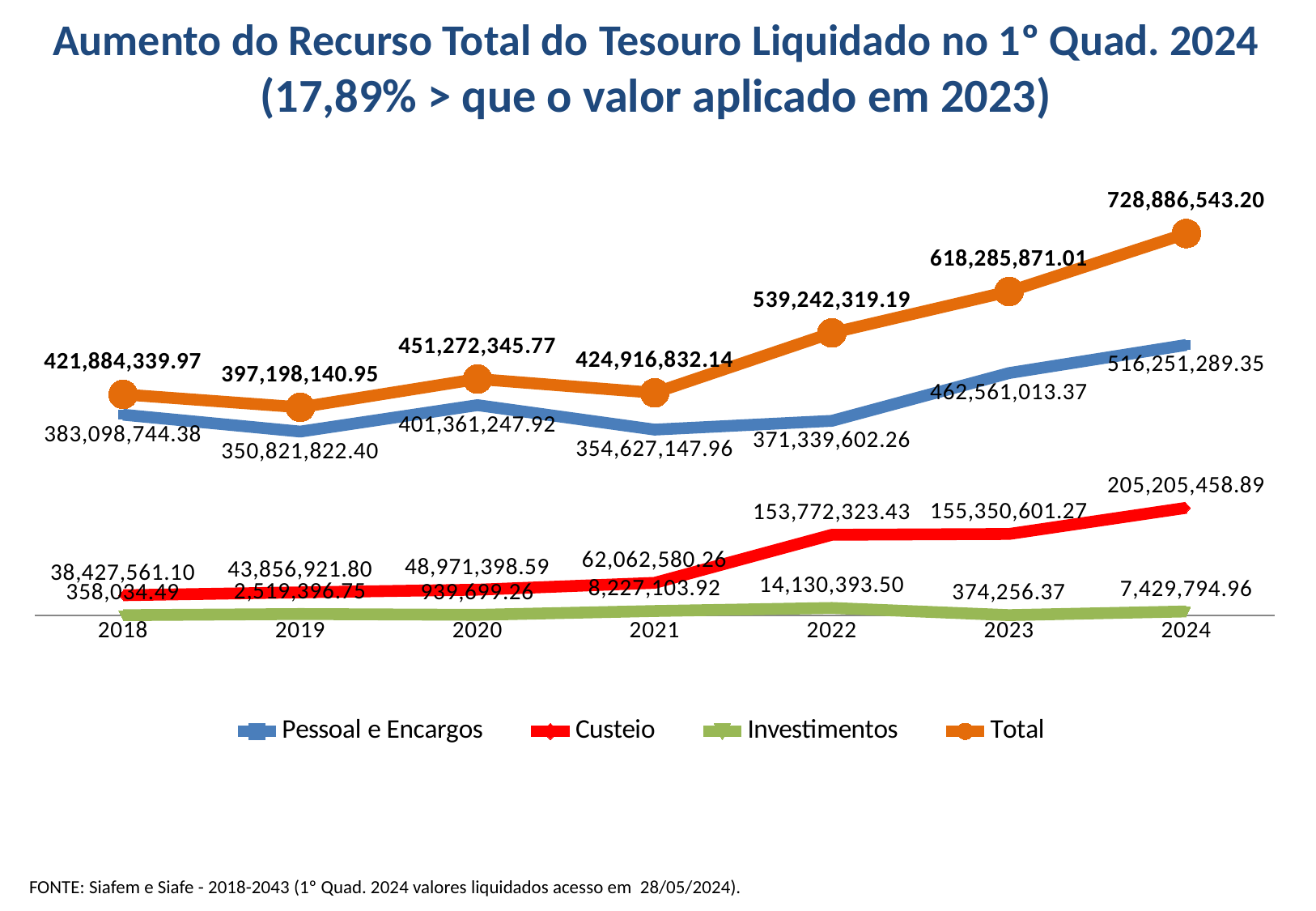
Which is larger for Pessoal e Encargos: the value in 2020 or in 2021? 2020 How many series does the legend list? 4 What is the difference between the Custeio values for 2024 and 2023? 49,854,857.62 What is the value of the Total series in 2024? 728,886,543.20 What kind of chart is shown on the slide? Line chart In which year is Pessoal e Encargos lowest? 2019 What is the value of Investimentos in 2023? 374,256.37 What is the difference between the Total values for 2024 and 2023? 110,600,672.19 What is the value of Pessoal e Encargos in 2019? 350,821,822.40 What is the value of Custeio in 2022? 153,772,323.43 How many years are shown on the x axis? 7 In which year is the Total series highest? 2024